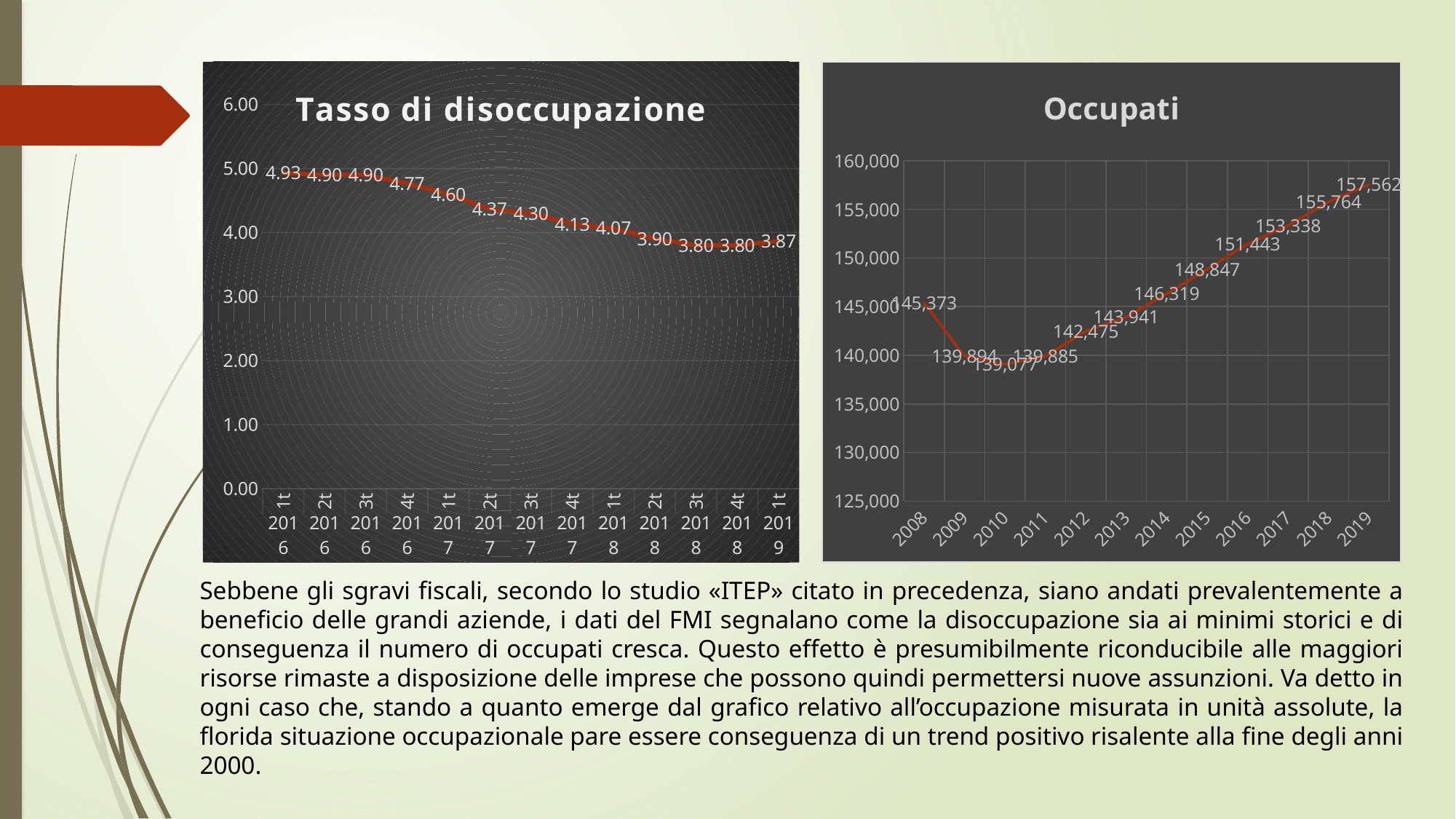
In the 'Tasso di disoccupazione' chart, which is larger, the value for 4t 2016 or the value for 1t 2018? 4t 2016 In the 'Tasso di disoccupazione' chart, what is the difference between the value for 1t 2016 and the value for 1t 2019? 1.06 What kind of chart is the 'Tasso di disoccupazione' chart? line chart In the 'Occupati' chart, what is the difference between the value for 2019 and the value for 2008? 12,189 How many data points are plotted in the 'Tasso di disoccupazione' chart? 13 In the 'Occupati' chart, which year has the lowest value? 2010 In the 'Occupati' chart, which year has the highest value? 2019 In the 'Occupati' chart, what is the value for 2019? 157,562 In the 'Tasso di disoccupazione' chart, what is the value for 1t 2019? 3.87 In the 'Tasso di disoccupazione' chart, what is the value for 1t 2016? 4.93 In the 'Tasso di disoccupazione' chart, do the values generally rise or fall from 1t 2016 to 1t 2019? fall How many years are plotted in the 'Occupati' chart? 12